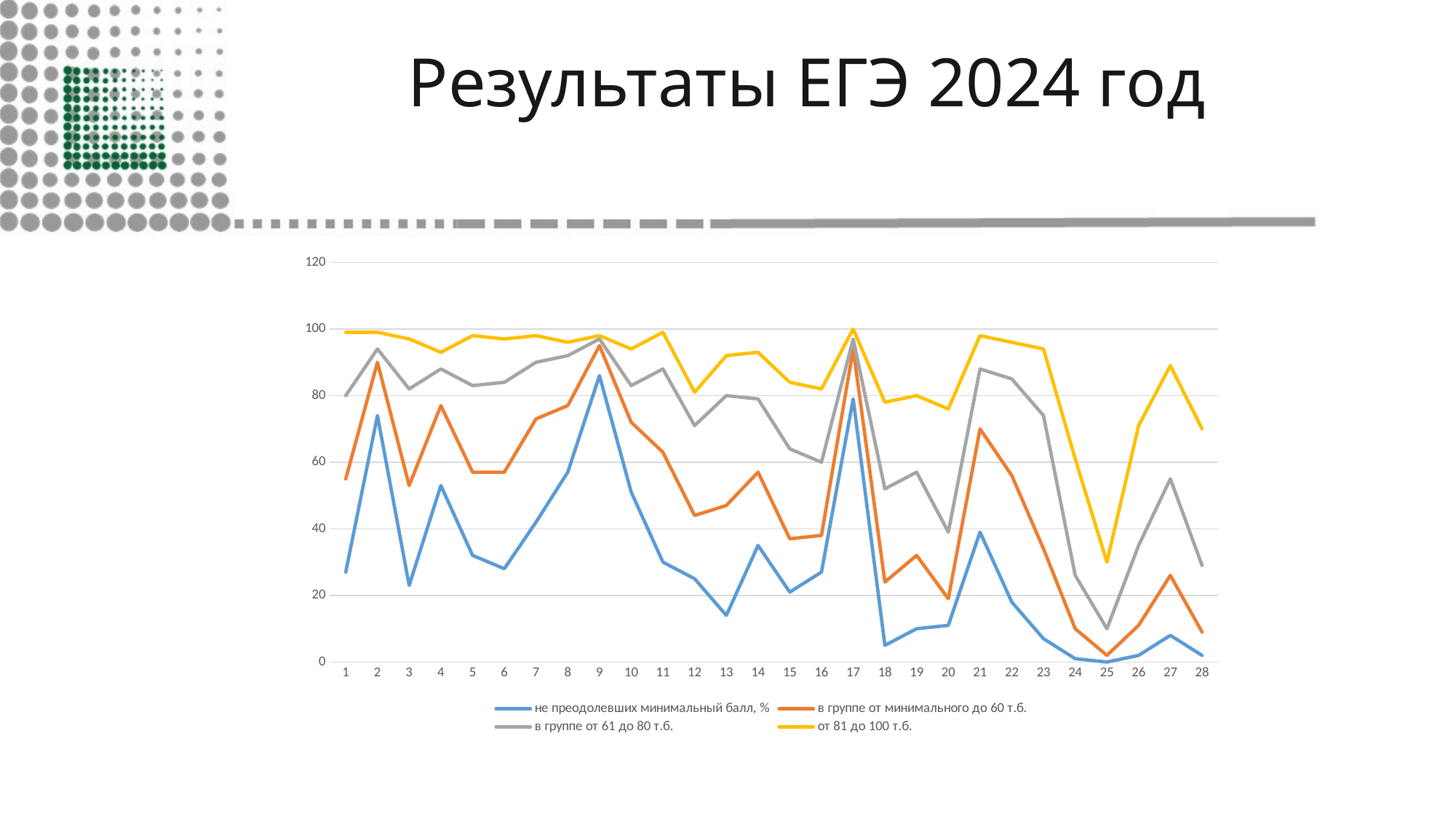
Is the value of the series 'в группе от 61 до 80 т.б.' at point 25 greater or less than 20? less At which x-axis point does the series 'не преодолевших минимальный балл, %' reach its highest value? 9 At point 13, which series has the larger value: 'от 81 до 100 т.б.' or 'не преодолевших минимальный балл, %'? от 81 до 100 т.б. At which x-axis point does the series 'от 81 до 100 т.б.' reach its lowest value? 25 What kind of chart is shown on the slide? line chart How many points are plotted along the x axis? 28 How many series does the legend list? 4 Is the value of the series 'не преодолевших минимальный балл, %' at point 9 greater or less than 80? greater Does the series 'не преодолевших минимальный балл, %' rise or fall from point 21 to point 25? fall Is the value of the series 'не преодолевших минимальный балл, %' at point 25 greater or less than 20? less What is the title of the slide containing the chart? Результаты ЕГЭ 2024 год